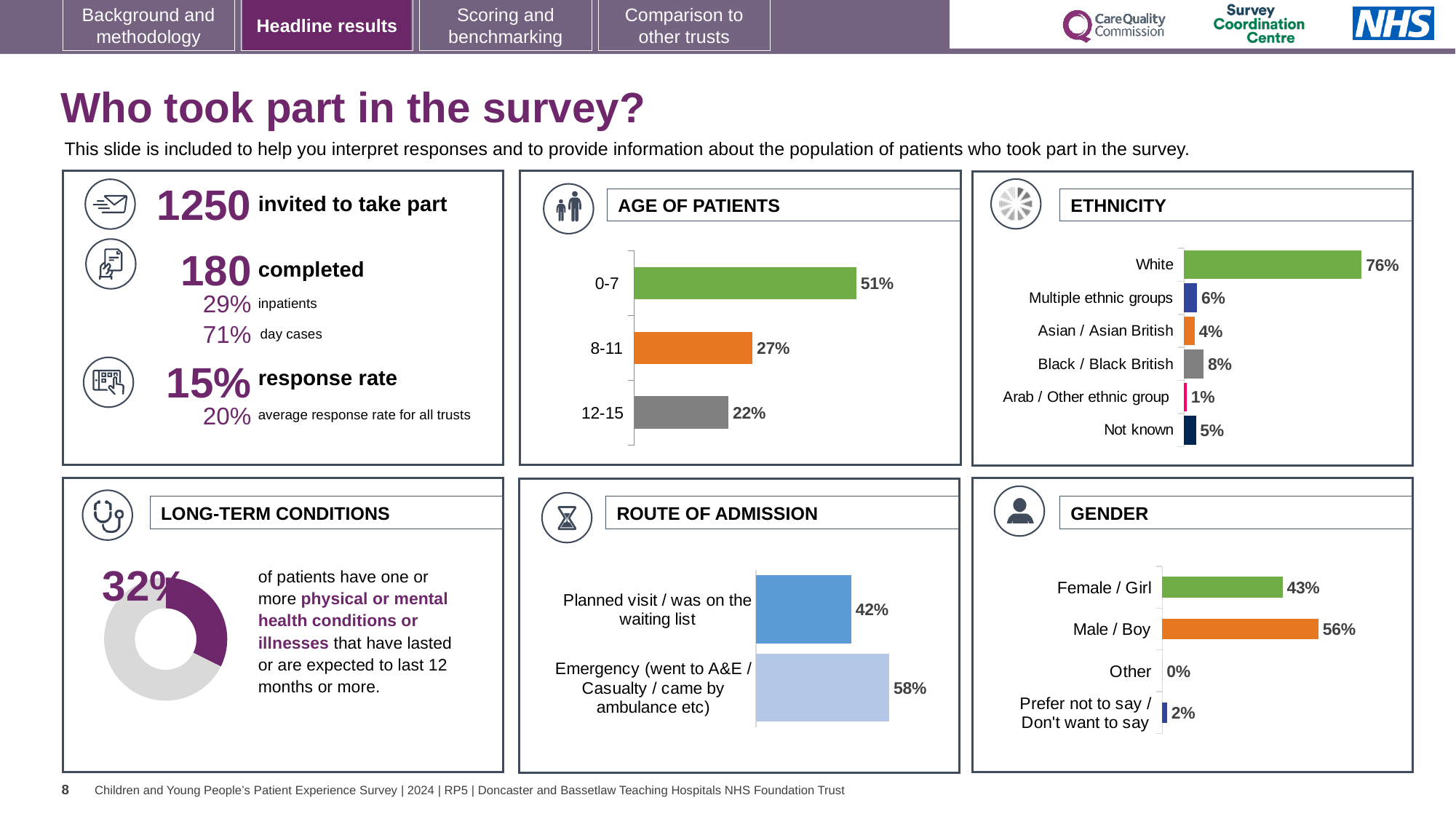
In the AGE OF PATIENTS chart, which age group has the lowest percentage? 12-15 In the GENDER chart, which category has the lowest percentage? Other In the AGE OF PATIENTS chart, what is the difference between the 0-7 and 8-11 percentages? 24% In the ETHNICITY chart, which category has the highest percentage? White What kind of chart is used in the LONG-TERM CONDITIONS panel? Donut (pie) chart In the ETHNICITY chart, how many ethnicity categories are shown? 6 In the ROUTE OF ADMISSION chart, what percentage of patients came via Emergency (went to A&E / Casualty / came by ambulance etc)? 58% In the GENDER chart, what percentage of patients are Male / Boy? 56% In the ETHNICITY chart, which is larger: Multiple ethnic groups or Asian / Asian British? Multiple ethnic groups In the ROUTE OF ADMISSION chart, what is the difference between the Emergency and Planned visit percentages? 16% In the ETHNICITY chart, what percentage of patients are Black / Black British? 8% In the AGE OF PATIENTS chart, what percentage of patients are aged 0-7? 51%